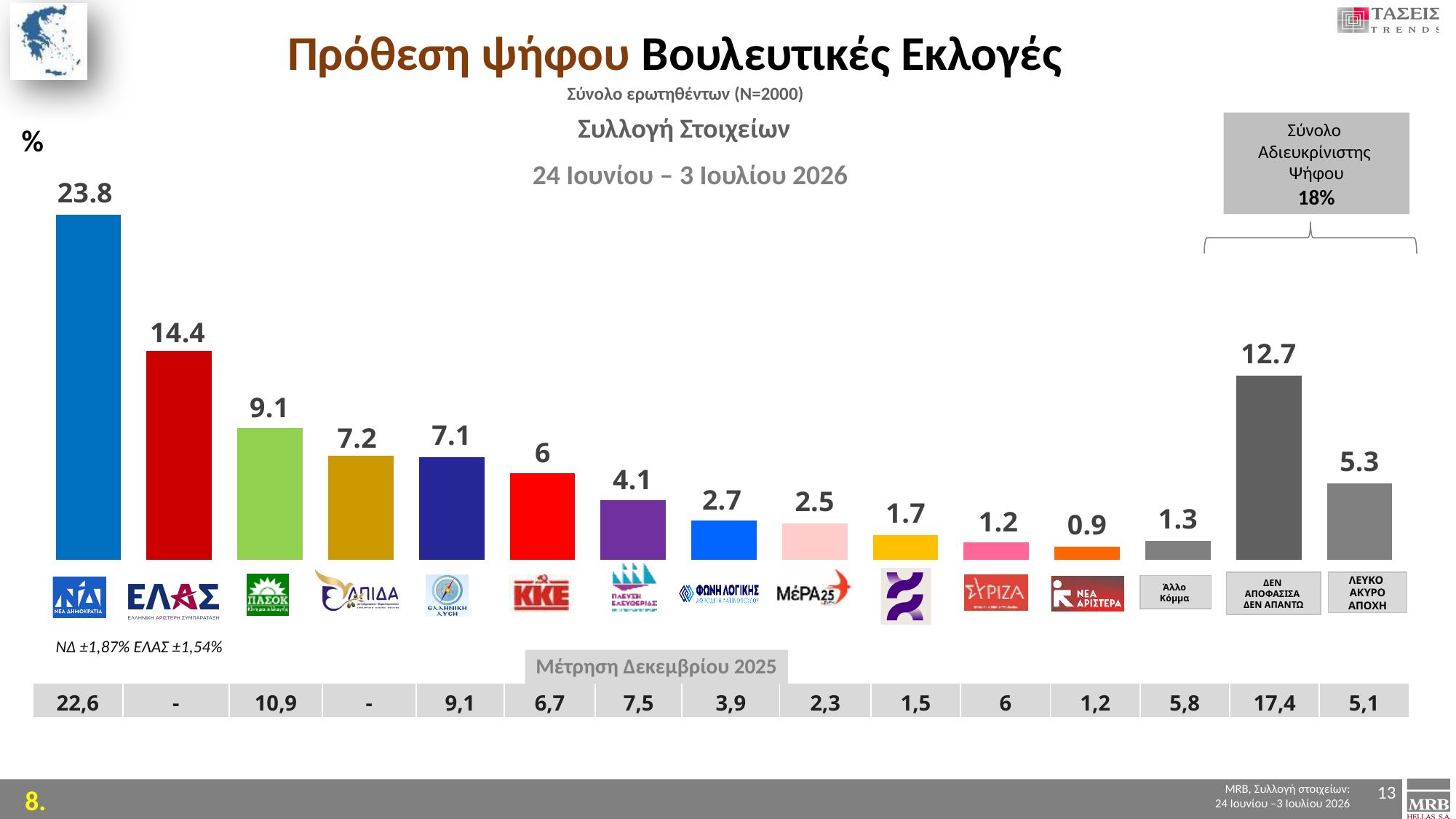
What is the value shown for ΝΔ (Νέα Δημοκρατία)? 23.8 What is the difference between the values for ΝΔ and ΕΛΑΣ? 9.4 What is the value shown for ΠΑΣΟΚ? 9.1 What is the value shown for ΚΚΕ? 6 Which is larger, the value for ΣΥΡΙΖΑ or the value for ΜέΡΑ25? ΜέΡΑ25 What was the value for ΝΔ in the Μέτρηση Δεκεμβρίου 2025 row? 22,6 Which party has the highest value in the chart? ΝΔ (Νέα Δημοκρατία) What is the value shown for the bar labelled ΔΕΝ ΑΠΟΦΑΣΙΣΑ ΔΕΝ ΑΠΑΝΤΩ? 12.7 Which bar has the lowest value in the chart? Νέα Αριστερά (0.9) What percentage is given in the box labelled Σύνολο Αδιευκρίνιστης Ψήφου? 18% How many bars are plotted in the chart? 15 What kind of chart is shown on the slide? Bar chart